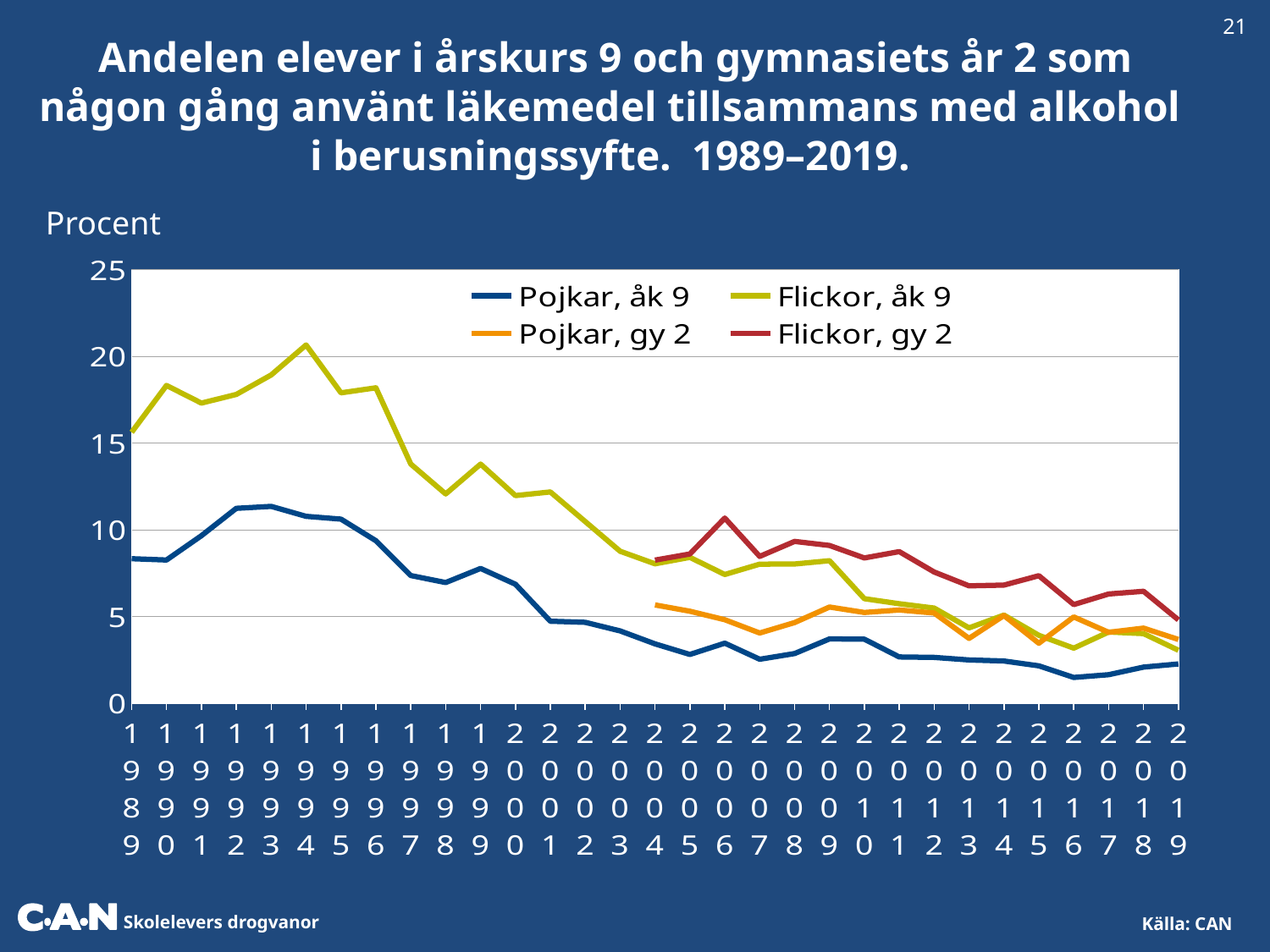
How many series does the legend list? 4 Does the Flickor, åk 9 series generally rise or fall from 1994 to 2019? fall Is the value for Flickor, åk 9 in 1989 greater or less than 15? greater Which series reaches the highest value anywhere on the chart? Flickor, åk 9 Is the value for Flickor, åk 9 in 1994 greater or less than 20? greater What label is shown above the y axis? Procent Is the value for Pojkar, åk 9 in 2019 greater or less than 5? less In 2006, which series is higher: Flickor, gy 2 or Pojkar, gy 2? Flickor, gy 2 In which year does the Flickor, åk 9 series reach its peak? 1994 How many years are plotted along the x axis? 31 In which year do the Pojkar, gy 2 and Flickor, gy 2 series first appear on the chart? 2004 What kind of chart is shown on the slide? line chart